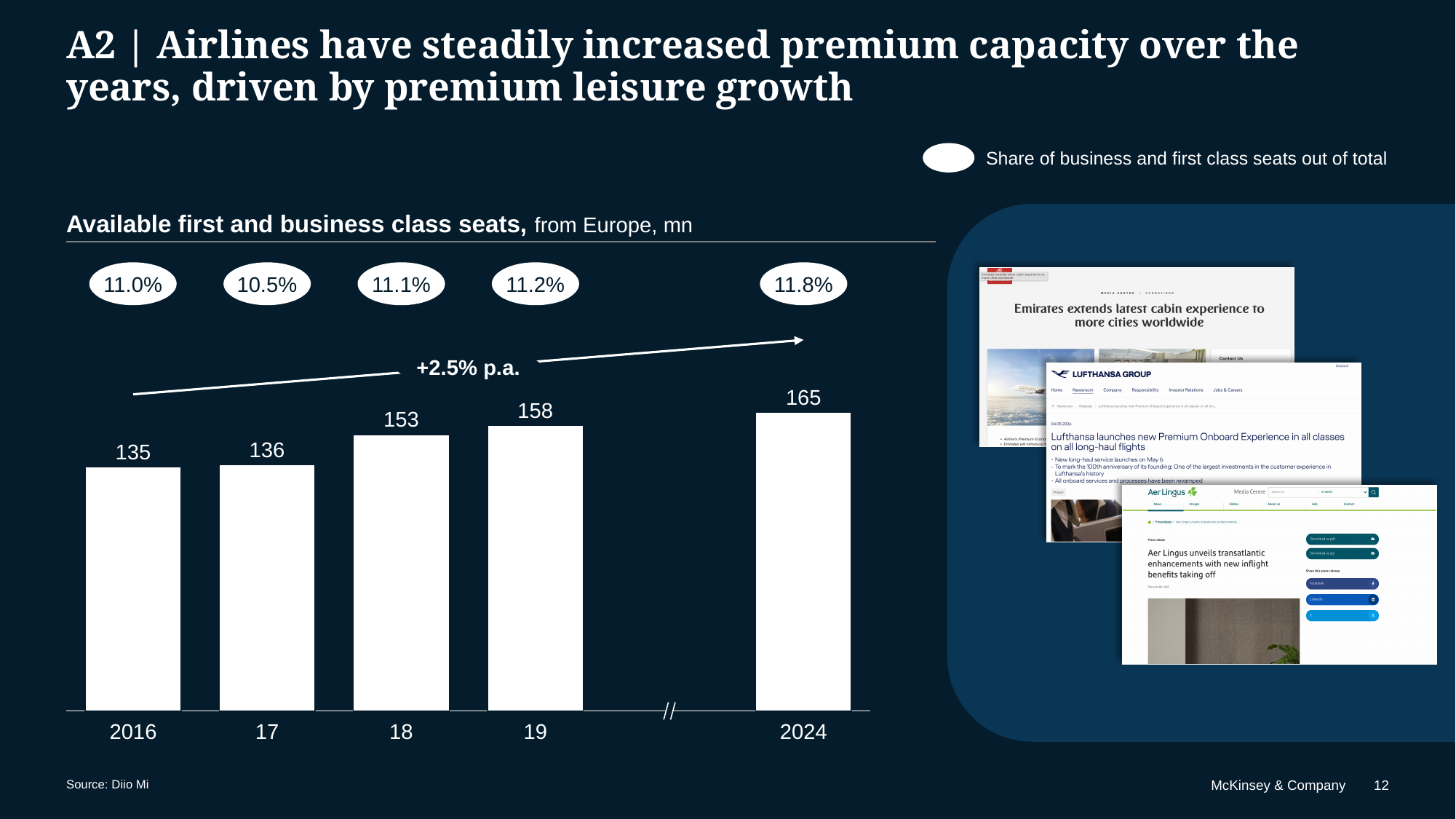
Do the values for available first and business class seats rise or fall from 2016 to 2024? Rise What is the value for 2016 in the chart of available first and business class seats? 135 Which year has the lowest number of available first and business class seats? 2016 What kind of chart is used to show available first and business class seats? Bar chart What share of business and first class seats out of total is shown for 2024? 11.8% Which year has the highest number of available first and business class seats? 2024 What is the difference between the 2024 and 2016 values for available first and business class seats? 30 What annual growth rate is annotated on the chart? +2.5% p.a. What is the value for 2024 in the chart of available first and business class seats? 165 How many years are shown as bars in the chart? 5 What is the value for 2018 in the chart of available first and business class seats? 153 Which is larger, the value for 2018 or the value for 2019? 2019